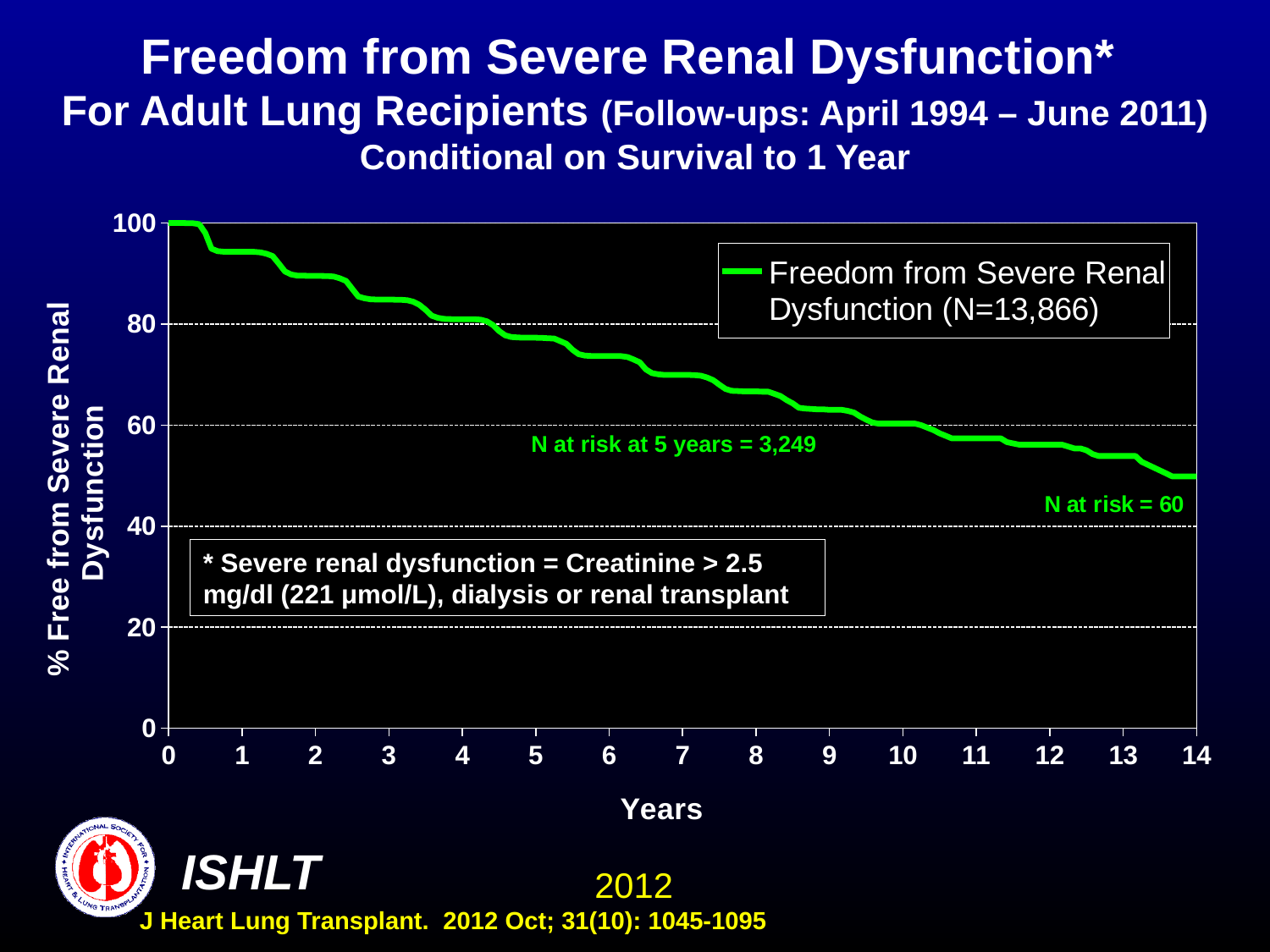
Does the freedom from severe renal dysfunction curve rise or fall as years increase? fall How many series does the legend list? 1 Is the value of the curve at year 14 greater or less than 60? less What is the N given in the legend for the Freedom from Severe Renal Dysfunction series? N=13,866 What is the N at risk at 5 years according to the annotation on the chart? 3,249 What is the value of the curve at year 0? 100 Is the value of the curve at year 7 greater or less than 80? less What is the label of the x axis? Years Is the value of the curve at year 2 greater or less than 80? greater What kind of chart is shown on the slide? line chart What is the N at risk at the end of the curve according to the annotation on the chart? 60